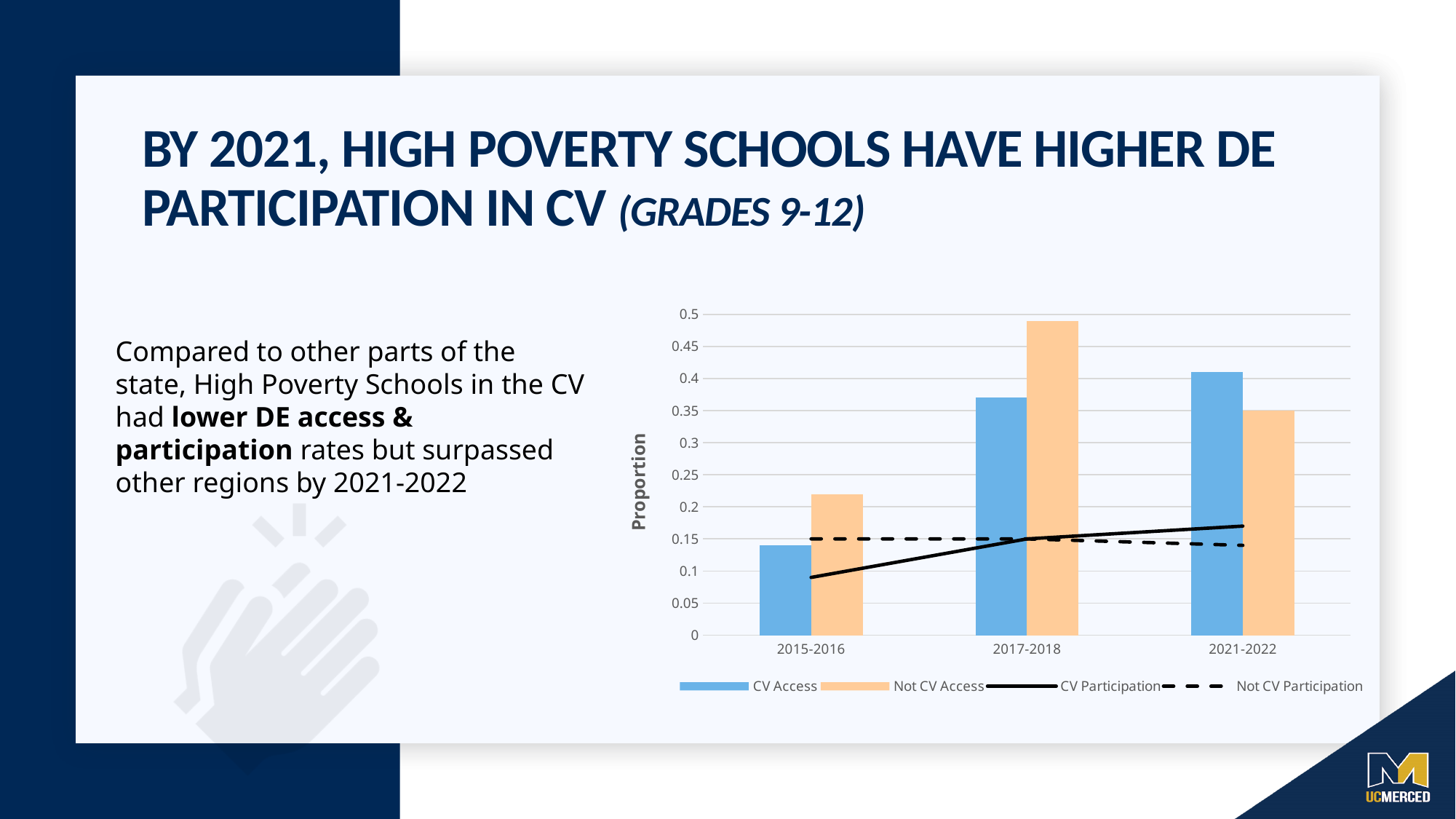
Is the Not CV Access value for 2017-2018 greater or less than 0.45? greater Which school year has the highest Not CV Access bar? 2017-2018 What kind of chart is shown on the slide? Combined bar and line chart In 2021-2022, which is larger, CV Access or Not CV Access? CV Access Is the CV Participation value for 2015-2016 greater or less than 0.1? less How many school-year categories are shown on the x axis of the chart? 3 Which school year has the lowest CV Access bar? 2015-2016 What is the label on the vertical axis of the chart? Proportion How many series does the chart legend list? 4 Does the CV Participation line rise or fall from 2015-2016 to 2021-2022? rise Is the CV Access value for 2021-2022 greater or less than 0.4? greater In 2015-2016, which is larger, CV Access or Not CV Access? Not CV Access